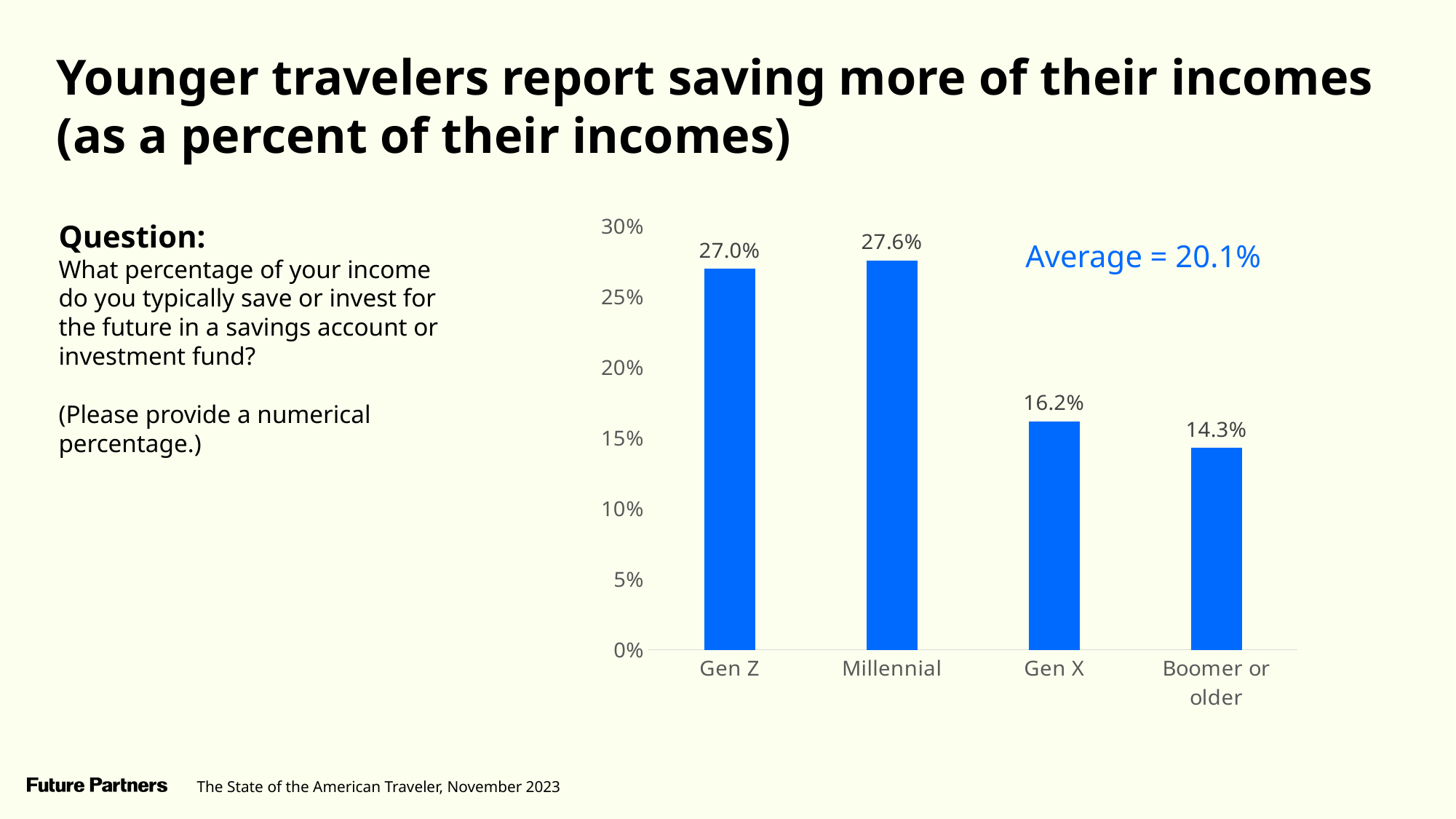
What kind of chart is shown on the slide? Bar chart Which generation reports saving the lowest percentage of income? Boomer or older What percentage of income do Gen X travelers report saving? 16.2% What is the difference between the Gen X value and the Boomer or older value? 1.9% How many generation categories are shown on the chart? 4 Which is larger, the value for Gen Z or the value for Gen X? Gen Z What is the value shown for Boomer or older travelers? 14.3% What average value is printed on the chart? 20.1% What is the difference between the Millennial value and the Gen Z value? 0.6% What is the value shown for Millennial travelers? 27.6% Which generation reports saving the highest percentage of income? Millennial What percentage of income do Gen Z travelers report saving? 27.0%